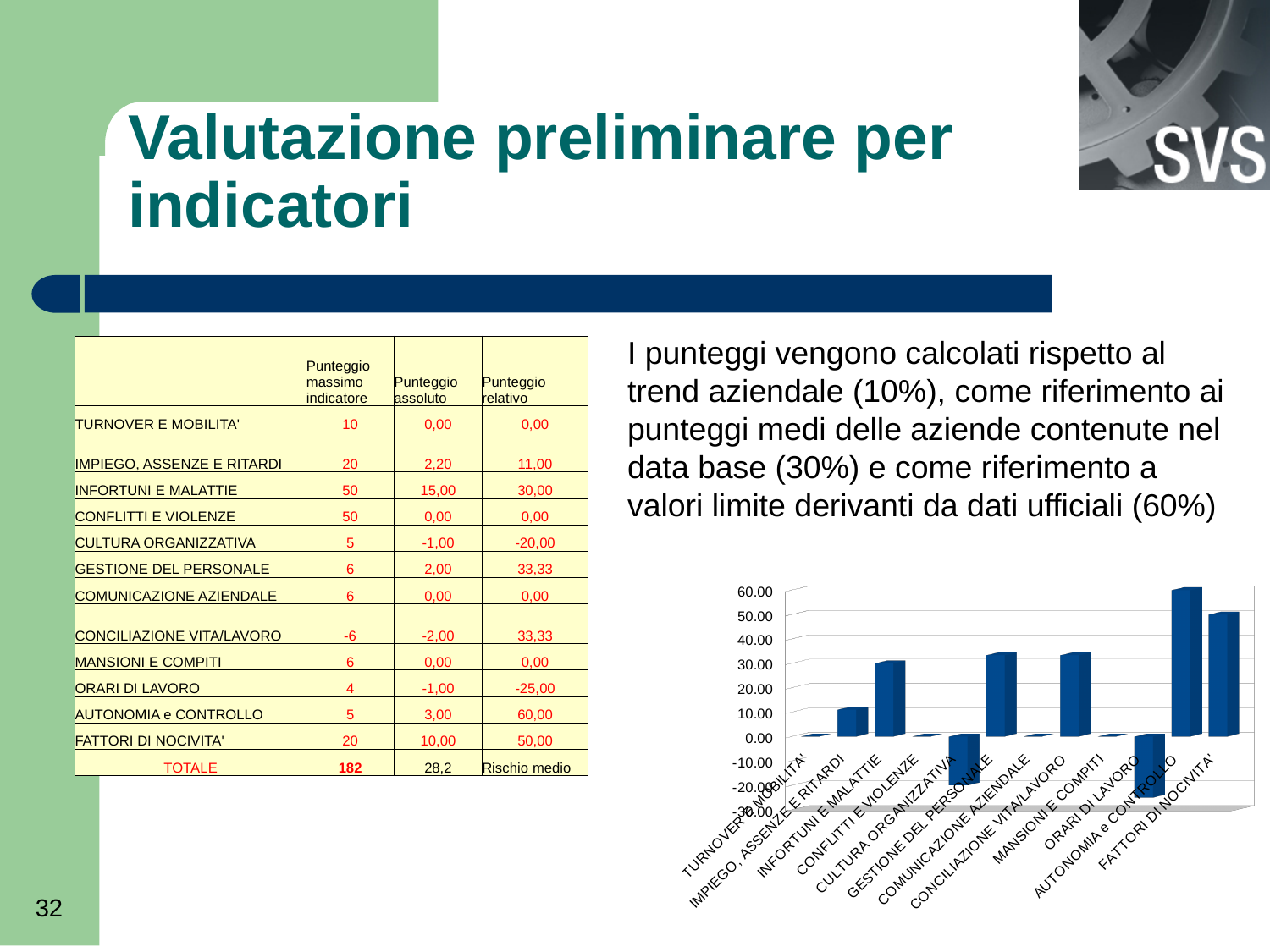
Is the bar for AUTONOMIA e CONTROLLO greater or less than 50.00? greater Is the bar for FATTORI DI NOCIVITA' greater or less than 40.00? greater Is the bar for IMPIEGO, ASSENZE E RITARDI greater or less than 20.00? less Which category has the highest bar in the chart? AUTONOMIA e CONTROLLO What is the highest value shown on the chart's vertical axis? 60.00 Which bar is taller, AUTONOMIA e CONTROLLO or FATTORI DI NOCIVITA'? AUTONOMIA e CONTROLLO Which bar is taller, INFORTUNI E MALATTIE or IMPIEGO, ASSENZE E RITARDI? INFORTUNI E MALATTIE What kind of chart is shown on the slide? bar chart How many categories are plotted along the x axis of the chart? 12